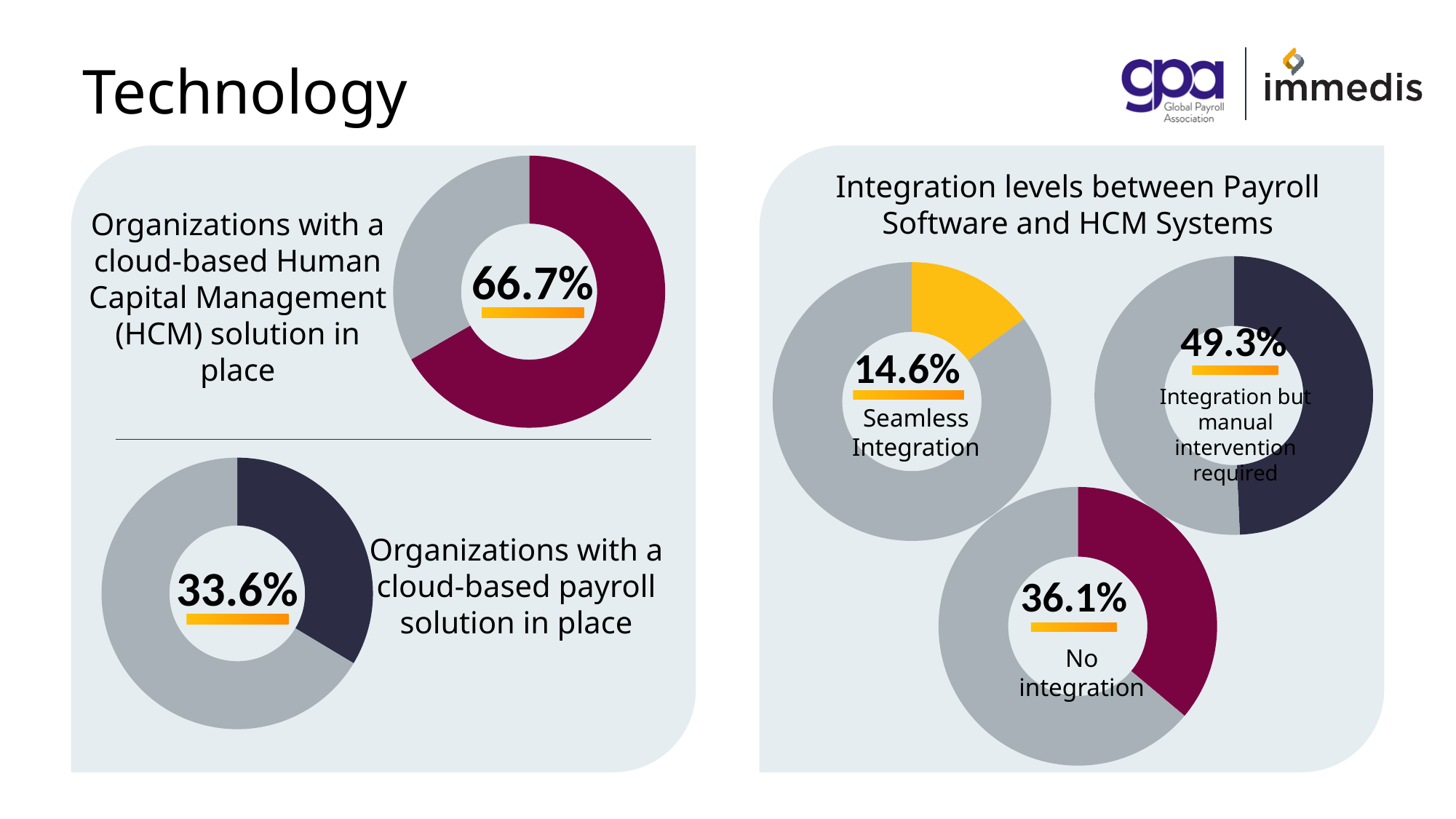
On the donut chart for organizations with a cloud-based Human Capital Management (HCM) solution in place, what percentage is shown? 66.7% In the 'Integration levels between Payroll Software and HCM Systems' charts, what is the difference in percentage points between 'Integration but manual intervention required' and 'No integration'? 13.2 In the 'Integration levels between Payroll Software and HCM Systems' charts, what percentage is shown for No integration? 36.1% Among the 'Integration levels between Payroll Software and HCM Systems' charts, which integration level has the lowest percentage? Seamless Integration In the 'Integration levels between Payroll Software and HCM Systems' charts, what percentage is shown for 'Integration but manual intervention required'? 49.3% How many donut charts are shown under the title 'Integration levels between Payroll Software and HCM Systems'? 3 On the left panel, what is the difference in percentage points between organizations with a cloud-based HCM solution and organizations with a cloud-based payroll solution? 33.1 What type of chart is used to show the percentage of organizations with a cloud-based payroll solution in place? Donut chart In the 'Integration levels between Payroll Software and HCM Systems' charts, what percentage is shown for Seamless Integration? 14.6% On the donut chart for organizations with a cloud-based payroll solution in place, what percentage is shown? 33.6% Which is larger: the percentage of organizations with a cloud-based HCM solution in place or the percentage with a cloud-based payroll solution in place? Cloud-based HCM solution Among the 'Integration levels between Payroll Software and HCM Systems' charts, which integration level has the highest percentage? Integration but manual intervention required